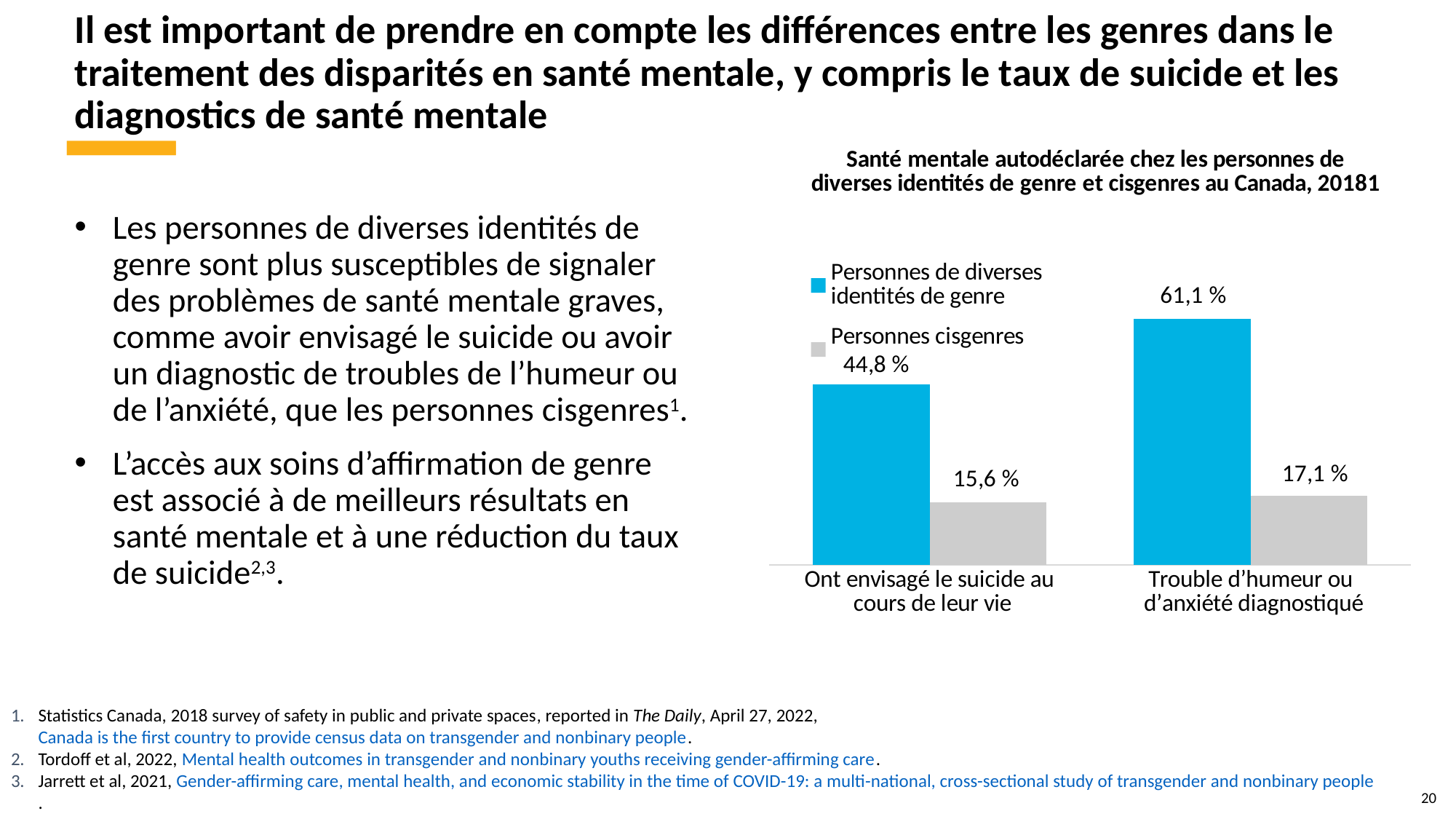
What is the value for 'Personnes cisgenres' in the category 'Trouble d'humeur ou d'anxiété diagnostiqué'? 17,1 % What is the value for 'Personnes de diverses identités de genre' in the category 'Ont envisagé le suicide au cours de leur vie'? 44,8 % What is the value for 'Personnes cisgenres' in the category 'Ont envisagé le suicide au cours de leur vie'? 15,6 % Which series has the larger value in the category 'Ont envisagé le suicide au cours de leur vie'? Personnes de diverses identités de genre What is the difference between the two series in the category 'Trouble d'humeur ou d'anxiété diagnostiqué'? 44,0 % What is the difference between the two series in the category 'Ont envisagé le suicide au cours de leur vie'? 29,2 % How many categories are shown on the x axis of the chart? 2 Which bar in the chart has the highest value? Personnes de diverses identités de genre, Trouble d'humeur ou d'anxiété diagnostiqué What kind of chart is shown on the slide? Bar chart How many series does the legend list? 2 What is the value for 'Personnes de diverses identités de genre' in the category 'Trouble d'humeur ou d'anxiété diagnostiqué'? 61,1 % Which bar in the chart has the lowest value? Personnes cisgenres, Ont envisagé le suicide au cours de leur vie